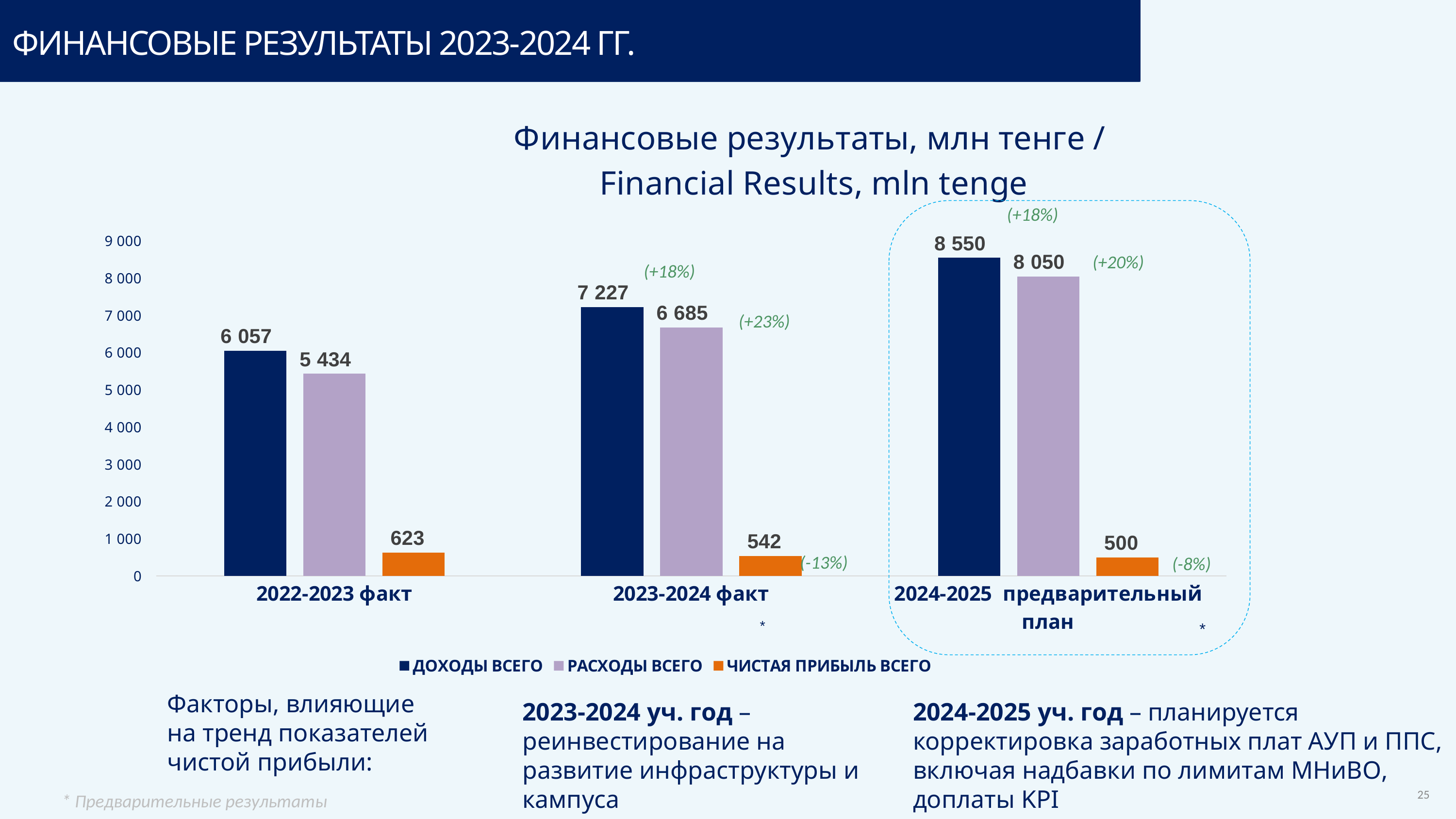
Which is larger for 2023-2024 факт: ДОХОДЫ ВСЕГО or РАСХОДЫ ВСЕГО? ДОХОДЫ ВСЕГО How many categories are shown on the x axis? 3 What is the value of РАСХОДЫ ВСЕГО for 2023-2024 факт? 6 685 What kind of chart is shown on the slide? bar chart Is the value of РАСХОДЫ ВСЕГО for 2022-2023 факт greater or less than 6 000? less What is the difference between ДОХОДЫ ВСЕГО and РАСХОДЫ ВСЕГО for 2024-2025 предварительный план? 500 How many series does the legend list? 3 Which category has the lowest value for ЧИСТАЯ ПРИБЫЛЬ ВСЕГО? 2024-2025 предварительный план What is the value of ДОХОДЫ ВСЕГО for 2022-2023 факт? 6 057 Which category has the highest value for ДОХОДЫ ВСЕГО? 2024-2025 предварительный план Do the values of ЧИСТАЯ ПРИБЫЛЬ ВСЕГО rise or fall across the categories from left to right? fall What is the value of ЧИСТАЯ ПРИБЫЛЬ ВСЕГО for 2024-2025 предварительный план? 500